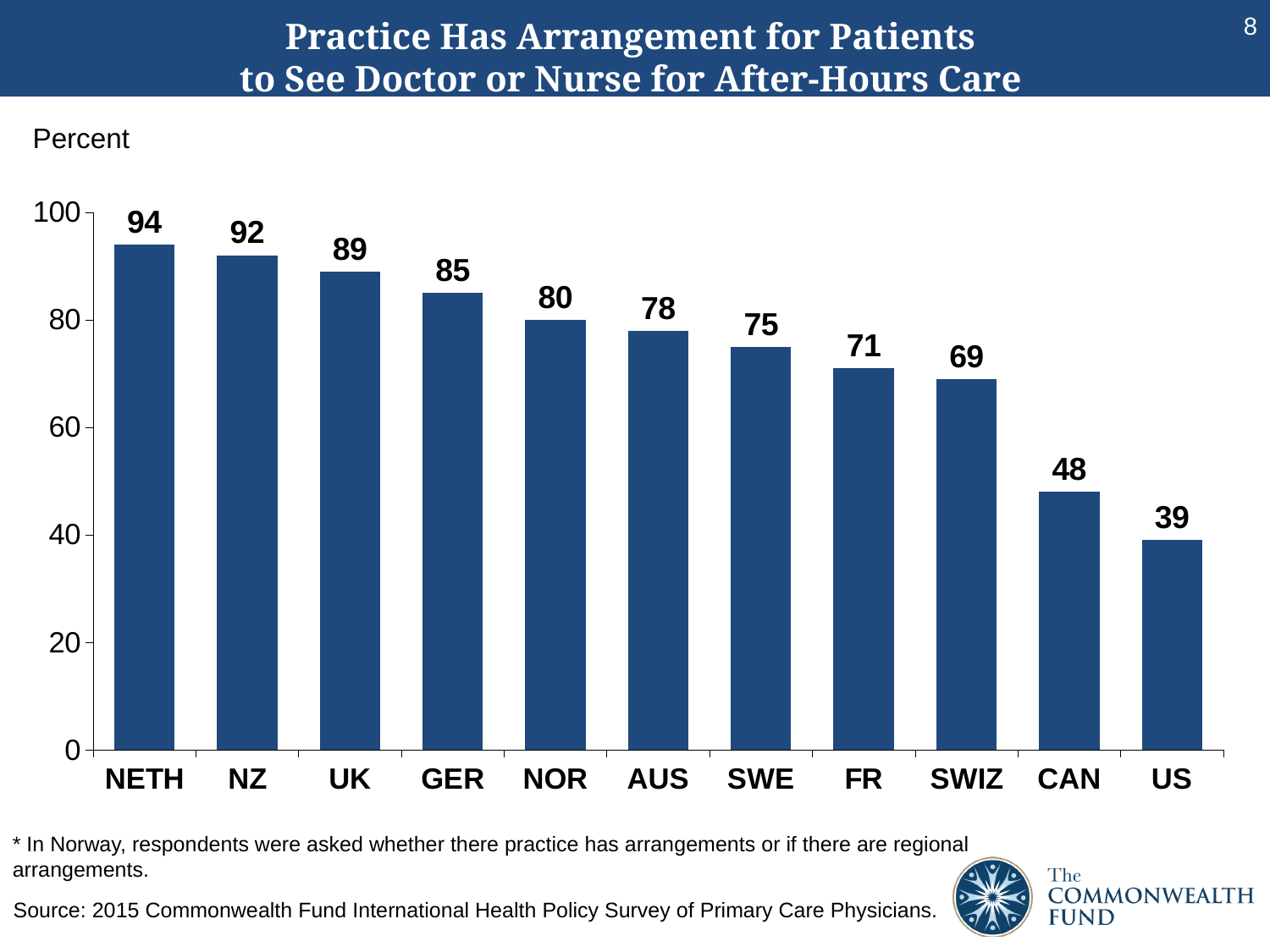
What is the difference between the values for NETH and US? 55 Do the values rise or fall from left to right along the x axis? fall What kind of chart is shown on the slide? bar chart Which country has the lowest value? US Which is larger, the value for UK or the value for AUS? UK What is the value for CAN? 48 Is the value for SWE greater or less than 60? greater What is the value for SWIZ? 69 How many countries are shown on the chart? 11 What is the value for GER? 85 Which country has the highest value? NETH What is the difference between the values for NOR and FR? 9